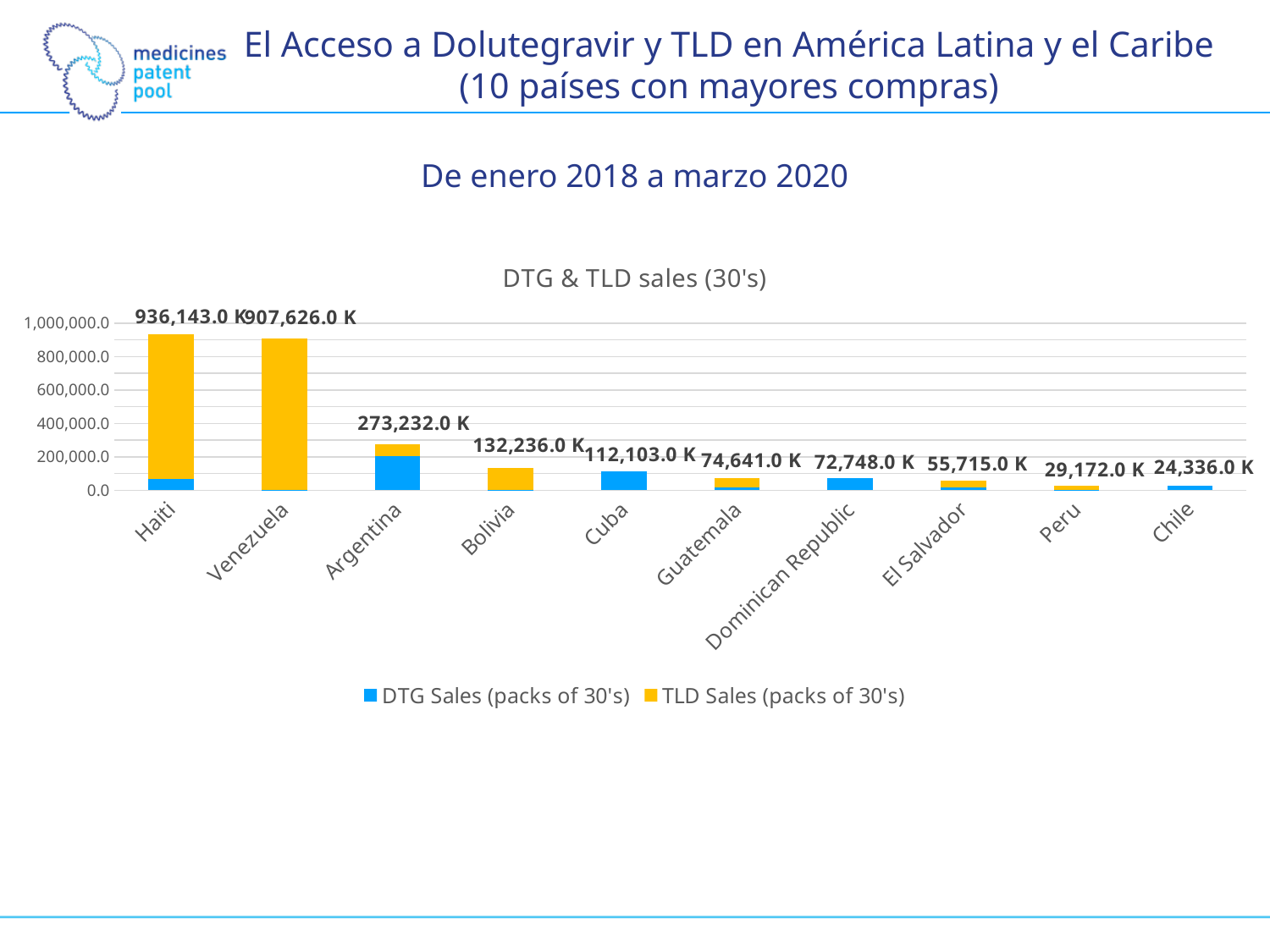
What kind of chart is shown on the slide? Stacked bar chart How many countries are shown on the x axis? 10 Is the total value for Argentina greater or less than 400,000.0? less Which country has the lowest total DTG & TLD sales? Chile What is the difference between the labelled totals for Peru and Chile? 4,836.0 K Which country has the highest total DTG & TLD sales? Haiti Which has a larger labelled total, Guatemala or Dominican Republic? Guatemala How many series does the legend list? 2 What is the difference between the labelled totals for Haiti and Venezuela? 28,517.0 K What is the total value labelled for Dominican Republic? 72,748.0 K What is the total value labelled for Argentina? 273,232.0 K What is the total value labelled for Haiti? 936,143.0 K